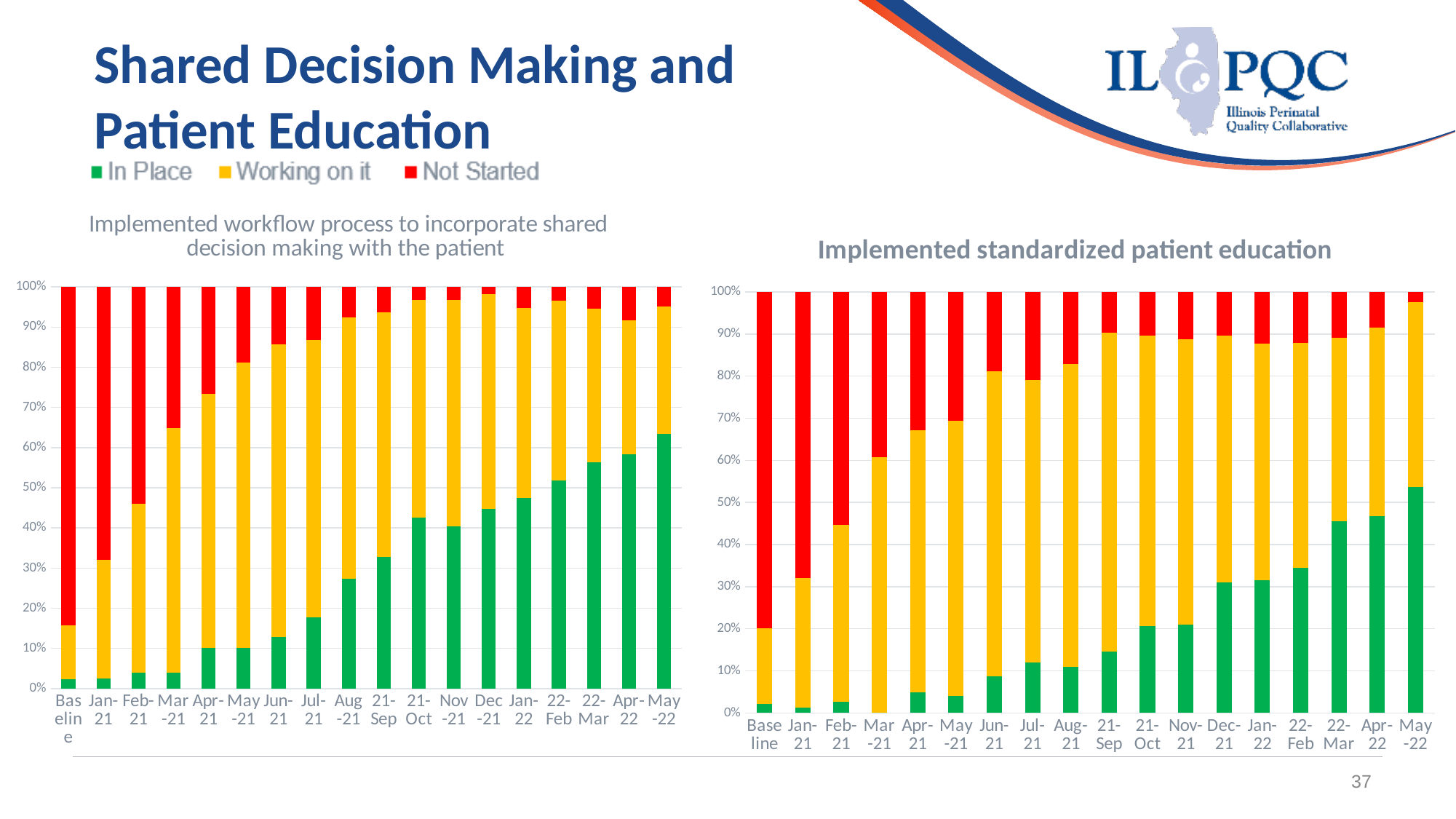
How many series does the legend list? 3 In the right chart (standardized patient education), is the 'In Place' value for Apr-22 greater or less than 50%? less In the left chart (shared decision making workflow), how many time periods are shown on the x axis? 18 What type of chart is used for 'Implemented standardized patient education'? Stacked bar chart In the left chart (shared decision making workflow), is the 'In Place' value for May-22 greater or less than 60%? greater In the right chart (standardized patient education), does the 'In Place' share generally rise or fall from Baseline to May-22? rise What are the three legend entries? In Place, Working on it, Not Started In the left chart (shared decision making workflow), which period has the highest 'In Place' share? May-22 In the right chart (standardized patient education), which period has the highest 'In Place' share? May-22 In the right chart (standardized patient education), how many time periods are shown on the x axis? 18 In the right chart (standardized patient education), is the 'Not Started' share larger at Baseline or at May-22? Baseline In the left chart (shared decision making workflow), is the 'In Place' value for Baseline greater or less than 10%? less